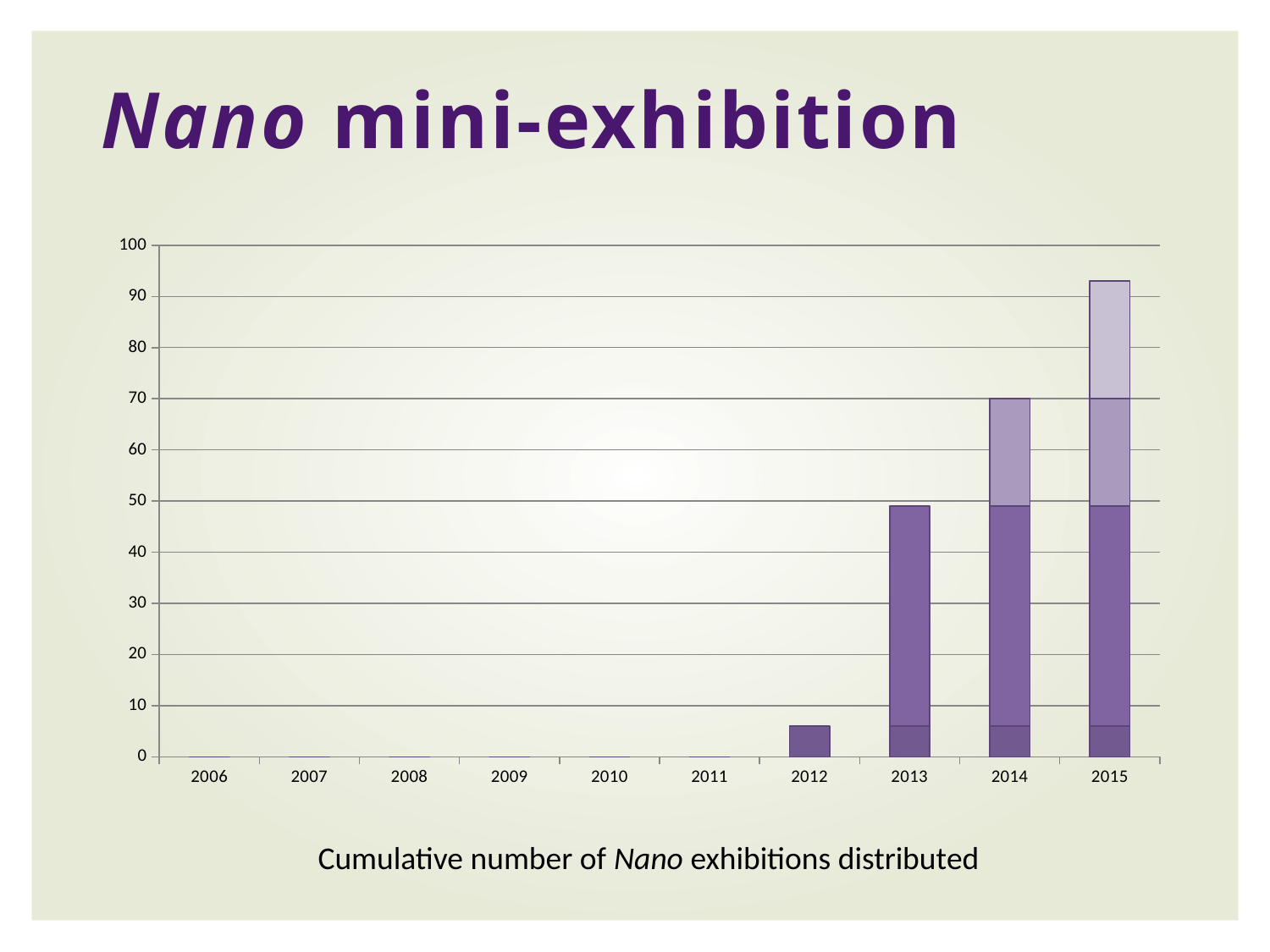
Is the value for 2015 greater or less than 90? greater Do the values rise or fall from 2012 to 2015? rise Which year has the highest bar in the chart? 2015 Which is larger, the value for 2012 or the value for 2013? 2013 What kind of chart is shown on the slide? bar chart How many years are shown on the x axis of the chart? 10 Which is larger, the value for 2014 or the value for 2015? 2015 Is the value for 2012 greater or less than 10? less Is the value for 2014 greater or less than 60? greater What is the first year shown on the x axis of the chart? 2006 What is the caption below the chart? Cumulative number of Nano exhibitions distributed